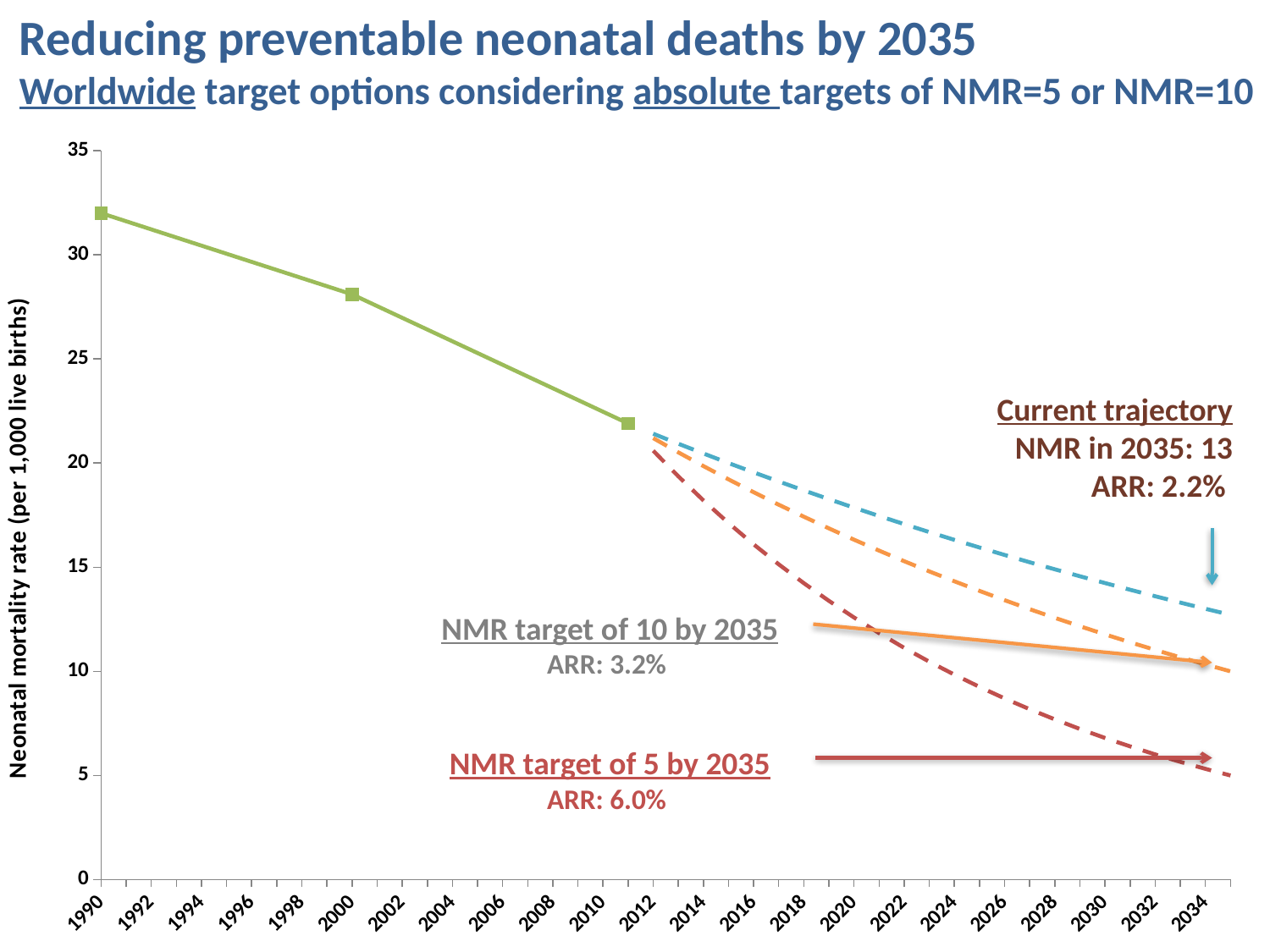
What kind of chart is shown on the slide? line chart Which scenario has the highest ARR: current trajectory, NMR target of 10, or NMR target of 5? NMR target of 5 by 2035 What is the label of the vertical axis? Neonatal mortality rate (per 1,000 live births) What ARR is needed to reach the NMR target of 5 by 2035? 6.0% How much higher is the current-trajectory NMR in 2035 (13) than the NMR target of 5? 8 Is the neonatal mortality rate plotted for 2000 greater or less than 30? less What ARR is needed to reach the NMR target of 10 by 2035? 3.2% Is the neonatal mortality rate plotted for 1990 greater or less than 30? greater According to the annotation, what is the NMR in 2035 under the current trajectory? 13 What is the ARR for the current trajectory? 2.2% Does the solid green line rise or fall from 1990 to 2011? fall What is the difference between the ARR for the NMR target of 5 (6.0%) and the ARR of the current trajectory (2.2%)? 3.8%